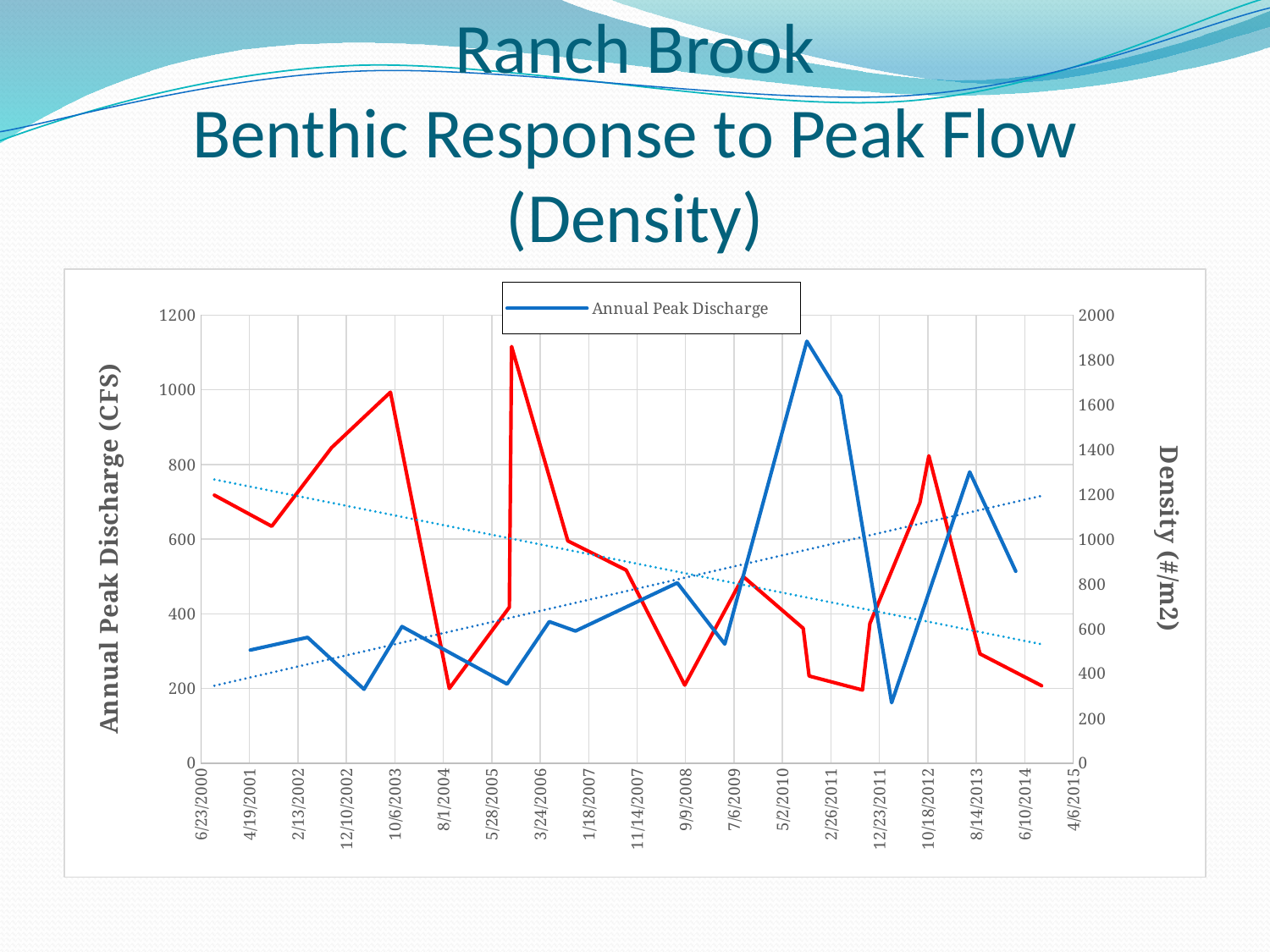
Is the highest value of the Annual Peak Discharge line greater or less than 1000 CFS? greater In which year does the Annual Peak Discharge line reach its highest value? 2010 Is the Annual Peak Discharge value at the peak near 8/14/2013 greater or less than 600 CFS? greater Does the dotted trend line that starts near 760 on the left axis rise or fall from left to right? fall What is the title of the right-hand vertical axis? Density (#/m2) What series name appears in the chart's legend? Annual Peak Discharge What kind of chart is shown on the slide? line chart Is the Annual Peak Discharge value at the last plotted point (near 6/10/2014) greater or less than 400 CFS? greater Does the dotted trend line that starts near 200 on the left axis rise or fall from left to right? rise How many series does the chart's legend list? 1 Which is larger for Annual Peak Discharge: the peak in 2010 or the peak near 8/14/2013? the peak in 2010